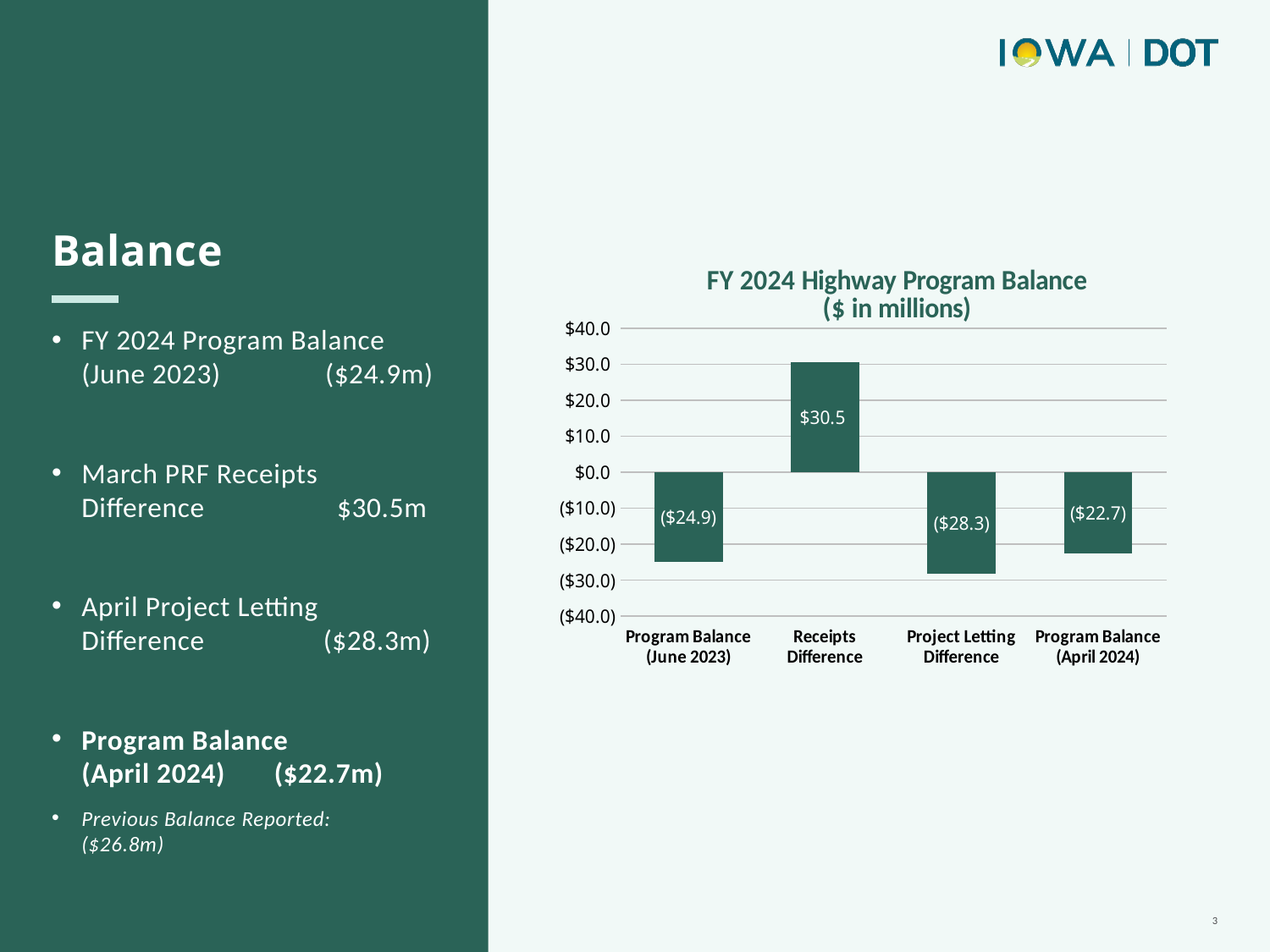
What is the value for Project Letting Difference in the chart? ($28.3) What kind of chart is shown on the slide? Bar chart What is the value for Program Balance (April 2024) in the chart? ($22.7) Which category has the highest value in the chart? Receipts Difference What is the difference between the Receipts Difference value and the Program Balance (April 2024) value? $53.2 What unit does the chart title say the values are in? $ in millions Which category has the lowest value in the chart? Project Letting Difference How many categories are shown on the x axis of the chart? 4 What is the value for Receipts Difference in the FY 2024 Highway Program Balance chart? $30.5 What is the value for Program Balance (June 2023) in the chart? ($24.9) Is the value for Receipts Difference greater or less than $20.0? greater Which is lower, the value for Program Balance (June 2023) or Program Balance (April 2024)? Program Balance (June 2023)